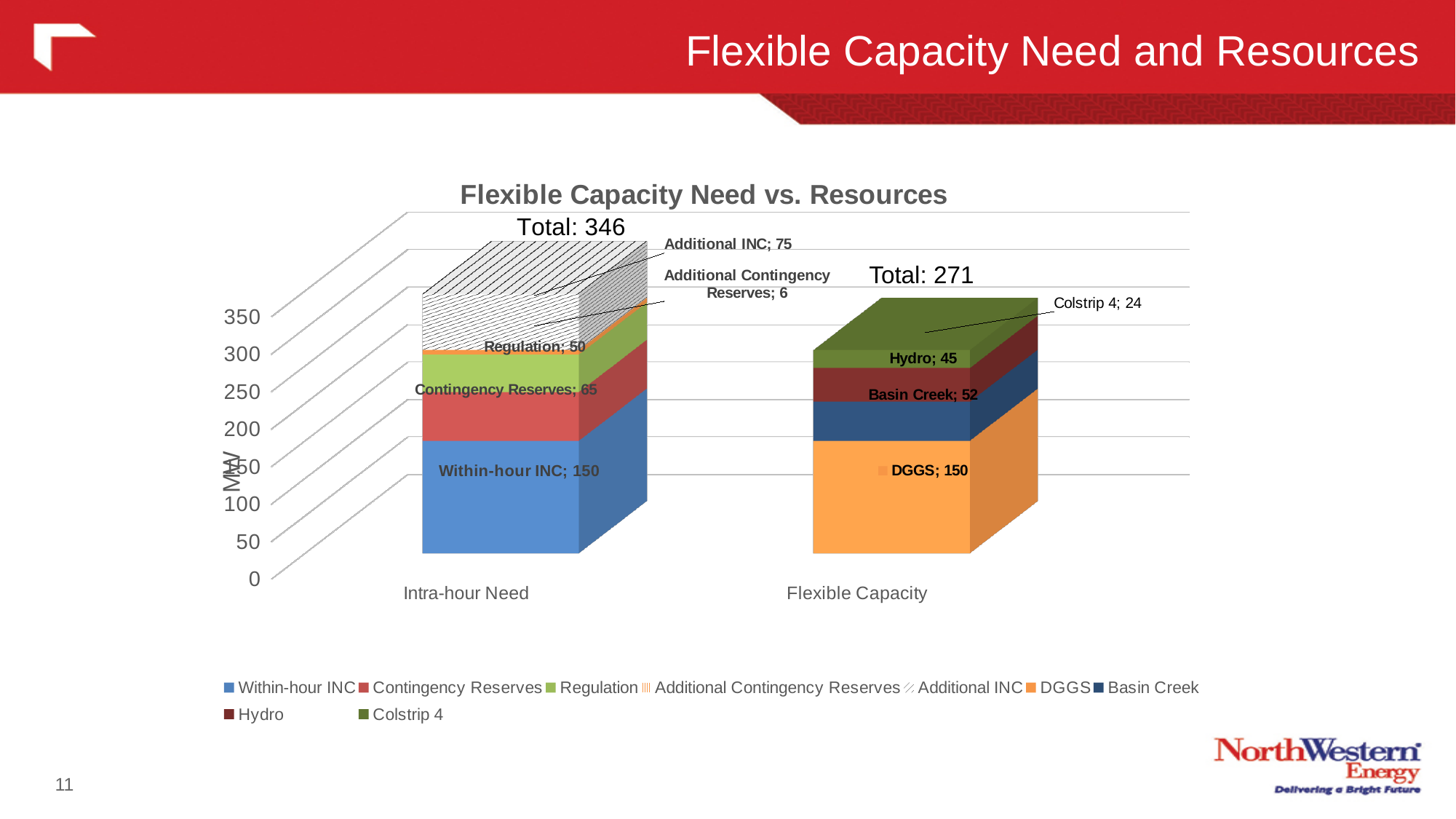
What kind of chart is shown on the slide? Stacked bar chart What is the value of Basin Creek in the Flexible Capacity bar? 52 What is the value of Colstrip 4 in the Flexible Capacity bar? 24 How many categories are shown on the x axis? 2 What is the value of Contingency Reserves in the Intra-hour Need bar? 65 How many series does the legend list? 9 What is the total of the Flexible Capacity stacked bar? 271 What is the value of Within-hour INC in the Intra-hour Need bar? 150 Which segment is the smallest in the Intra-hour Need bar? Additional Contingency Reserves What is the total of the Intra-hour Need stacked bar? 346 Which is larger, Hydro or Basin Creek in the Flexible Capacity bar? Basin Creek What is the difference between the Intra-hour Need total and the Flexible Capacity total? 75